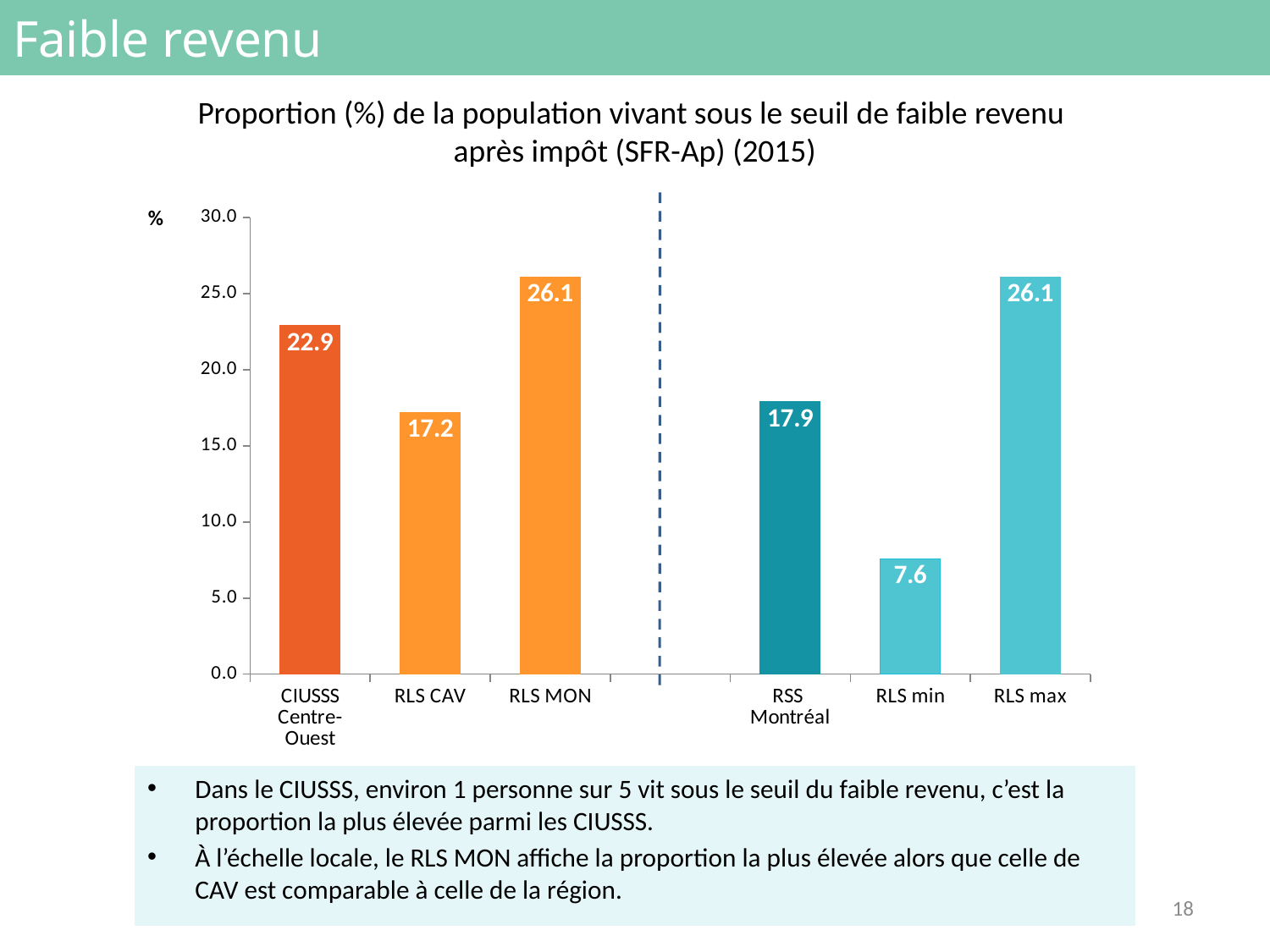
Which category has the lowest value? RLS min How many categories are shown on the x axis? 6 What is the difference between the values for CIUSSS Centre-Ouest and RSS Montréal? 5.0 What is the title of the chart? Proportion (%) de la population vivant sous le seuil de faible revenu après impôt (SFR-Ap) (2015) What kind of chart is shown on the slide? bar chart What is the value for RLS CAV? 17.2 Is the value for RLS max greater or less than 25.0? greater What is the difference between the values for RLS MON and RLS CAV? 8.9 What is the value for RLS min? 7.6 What is the value for RSS Montréal? 17.9 Which is larger, the value for RLS CAV or the value for RSS Montréal? RSS Montréal What is the value for CIUSSS Centre-Ouest? 22.9